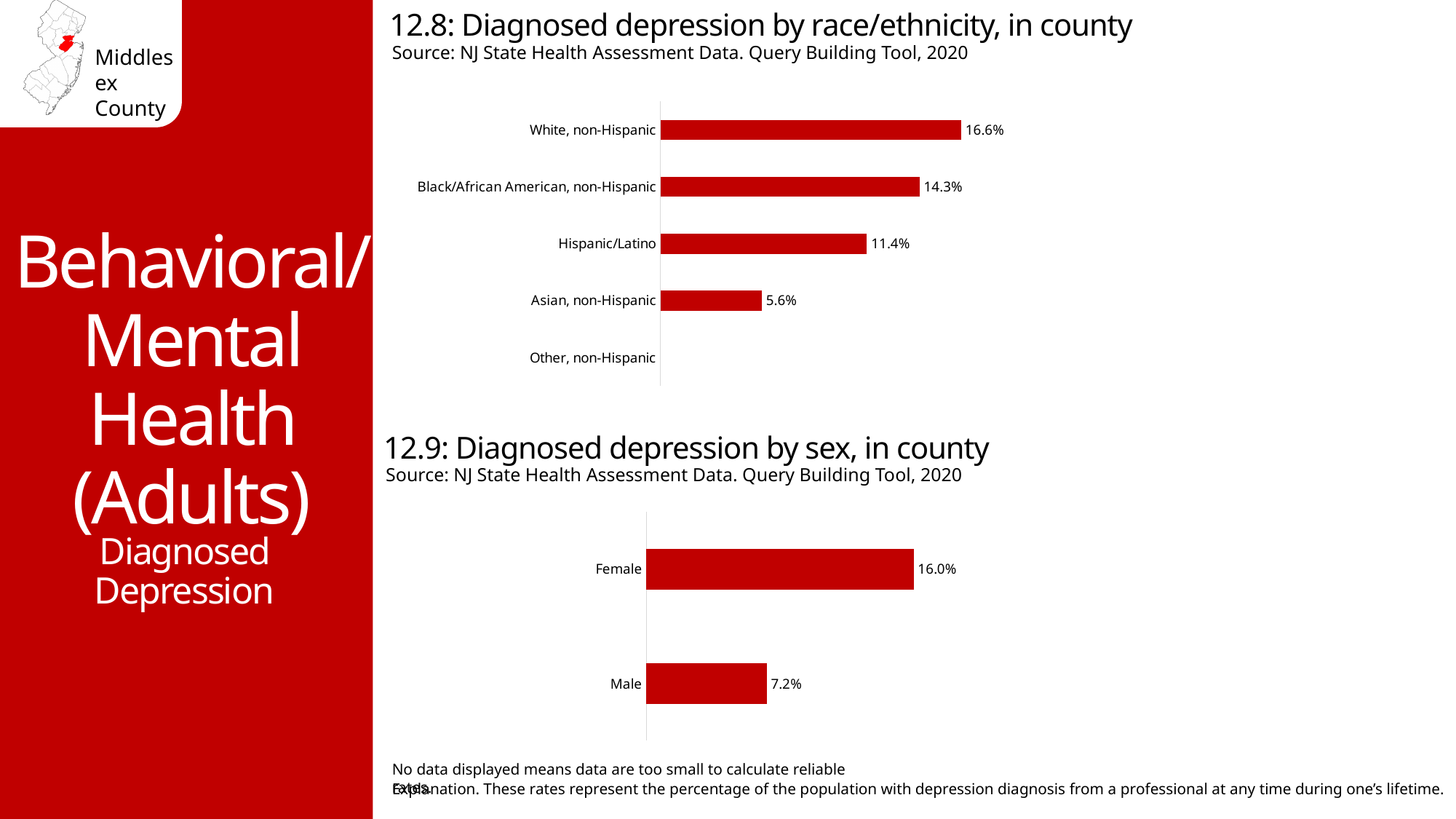
What kind of chart is '12.9: Diagnosed depression by sex, in county'? Bar chart In the chart '12.8: Diagnosed depression by race/ethnicity, in county', how many categories are listed on the axis? 5 In the chart '12.8: Diagnosed depression by race/ethnicity, in county', what is the value for Hispanic/Latino? 11.4% In the chart '12.9: Diagnosed depression by sex, in county', what is the value for Male? 7.2% In the chart '12.8: Diagnosed depression by race/ethnicity, in county', which category has no bar displayed? Other, non-Hispanic In the chart '12.8: Diagnosed depression by race/ethnicity, in county', which category has the highest value? White, non-Hispanic In the chart '12.9: Diagnosed depression by sex, in county', what is the difference between the Female and Male values? 8.8% In the chart '12.9: Diagnosed depression by sex, in county', which is larger, the value for Female or Male? Female In the chart '12.8: Diagnosed depression by race/ethnicity, in county', what is the difference between the values for White, non-Hispanic and Black/African American, non-Hispanic? 2.3% In the chart '12.8: Diagnosed depression by race/ethnicity, in county', which category with a displayed value has the lowest value? Asian, non-Hispanic In the chart '12.8: Diagnosed depression by race/ethnicity, in county', what is the value for White, non-Hispanic? 16.6% In the chart '12.9: Diagnosed depression by sex, in county', what is the value for Female? 16.0%